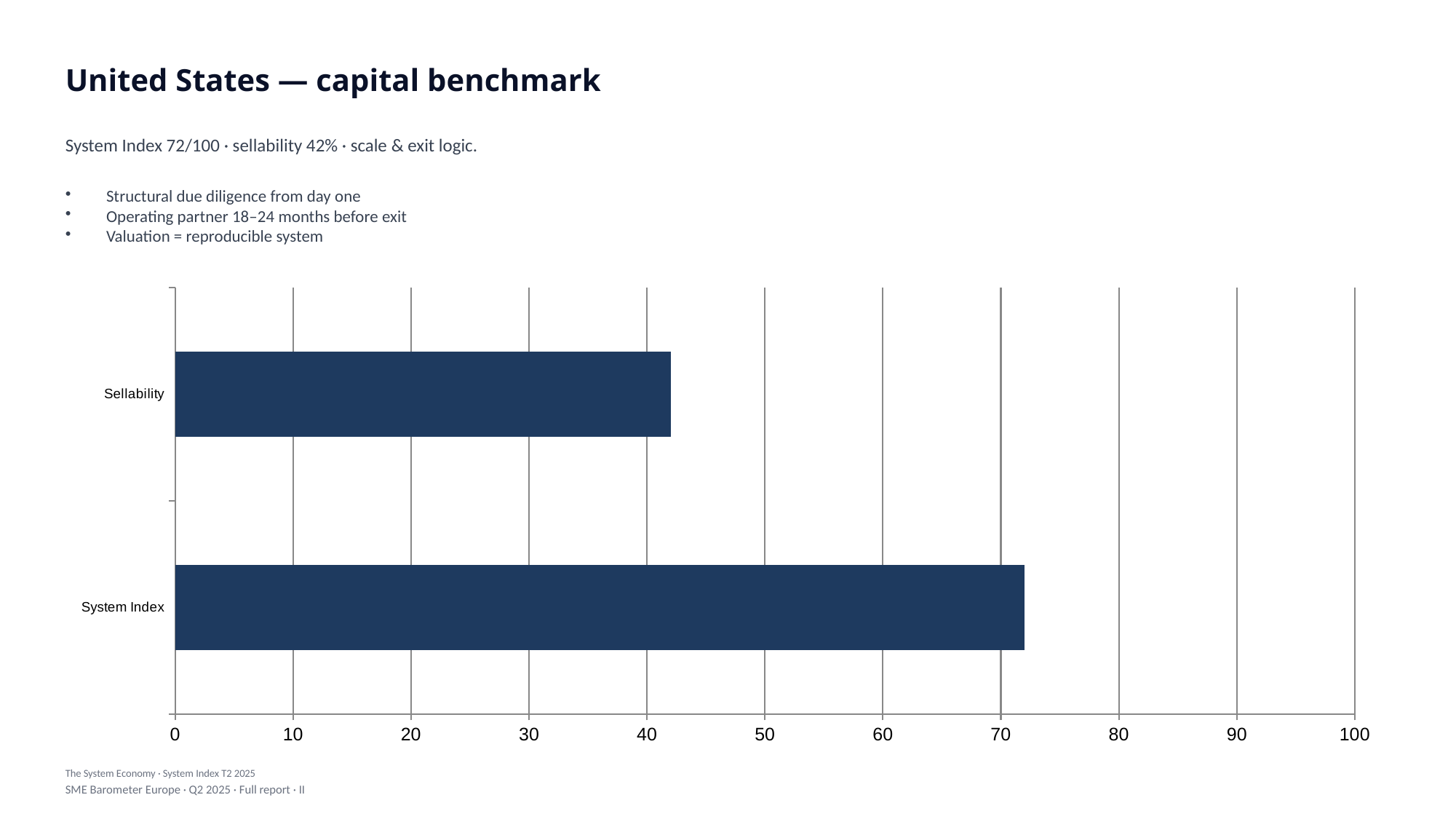
Which category has the lowest value? Sellability Which category has the highest value? System Index How many categories does the chart show? 2 Is the value for System Index greater or less than 80? less What is the title of the slide containing the chart? United States — capital benchmark What is the maximum value shown on the horizontal axis? 100 Is the value for System Index greater or less than 70? greater Is the value for Sellability greater or less than 50? less Which is larger, the value for System Index or the value for Sellability? System Index What kind of chart is shown on the slide? bar chart